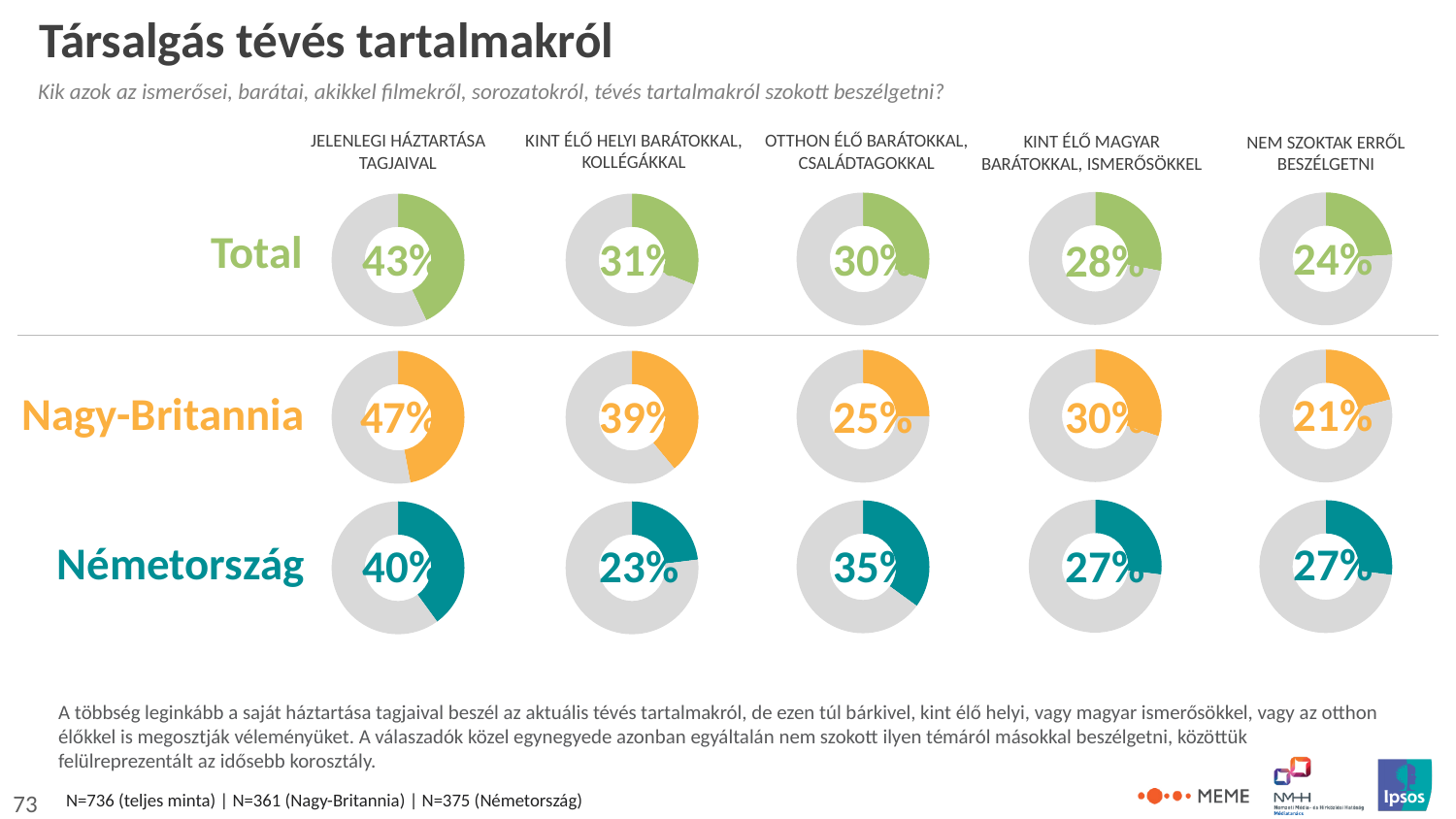
In the Nagy-Britannia row, what percentage is shown for 'Kint élő helyi barátokkal, kollégákkal'? 39% In the Németország row, which category has the lowest percentage? Kint élő helyi barátokkal, kollégákkal What type of chart is used to display the percentages on this slide? Donut (pie) chart How many rows of donut charts are on the slide? 3 In the Total row, what percentage is shown for 'Jelenlegi háztartása tagjaival'? 43% How many donut charts are shown in the Total row? 5 In the Total row, which category has the highest percentage? Jelenlegi háztartása tagjaival What is the difference between the Nagy-Britannia and Németország values for 'Jelenlegi háztartása tagjaival'? 7% In the Nagy-Britannia row, what percentage is shown for 'Nem szoktak erről beszélgetni'? 21% What colour are the donut charts in the Nagy-Britannia row? Orange For 'Otthon élő barátokkal, családtagokkal', which is larger: the Nagy-Britannia value or the Németország value? Németország In the Németország row, what percentage is shown for 'Otthon élő barátokkal, családtagokkal'? 35%